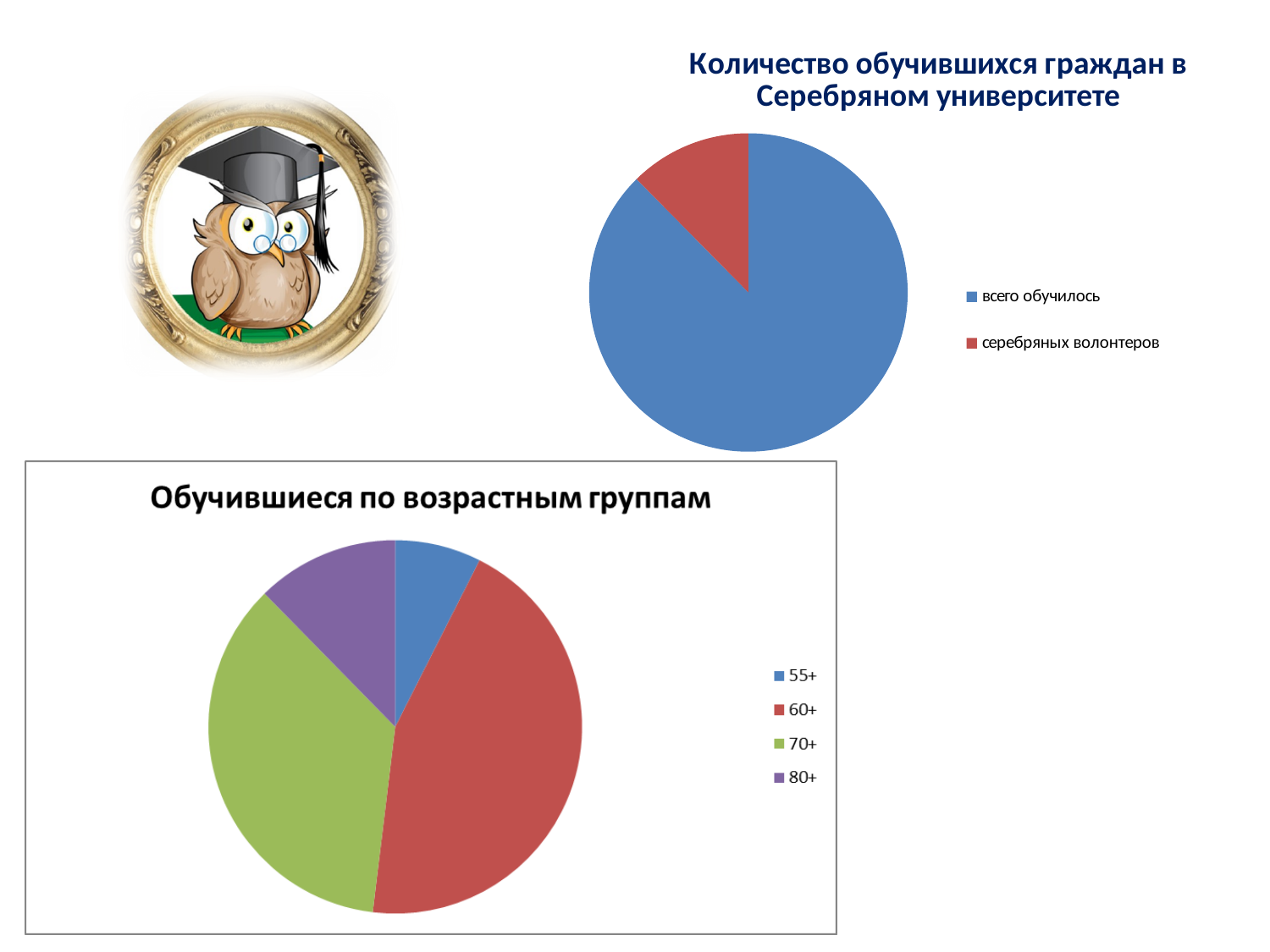
What kind of chart is the chart titled "Количество обучившихся граждан в Серебряном университете"? pie chart In the chart titled "Количество обучившихся граждан в Серебряном университете", which category has the larger slice? всего обучилось In the chart titled "Количество обучившихся граждан в Серебряном университете", what colour is the slice for серебряных волонтеров? red In the chart titled "Обучившиеся по возрастным группам", which slice is larger: 60+ or 70+? 60+ What kind of chart is the chart titled "Обучившиеся по возрастным группам"? pie chart In the chart titled "Количество обучившихся граждан в Серебряном университете", how many entries does the legend list? 2 In the chart titled "Обучившиеся по возрастным группам", what colour is the slice for 70+? green In the chart titled "Обучившиеся по возрастным группам", which slice is larger: 70+ or 55+? 70+ In the chart titled "Обучившиеся по возрастным группам", how many age groups are shown? 4 In the chart titled "Количество обучившихся граждан в Серебряном университете", how many slices does the pie have? 2 In the chart titled "Количество обучившихся граждан в Серебряном университете", which category has the smaller slice? серебряных волонтеров In the chart titled "Обучившиеся по возрастным группам", which age group has the largest slice? 60+